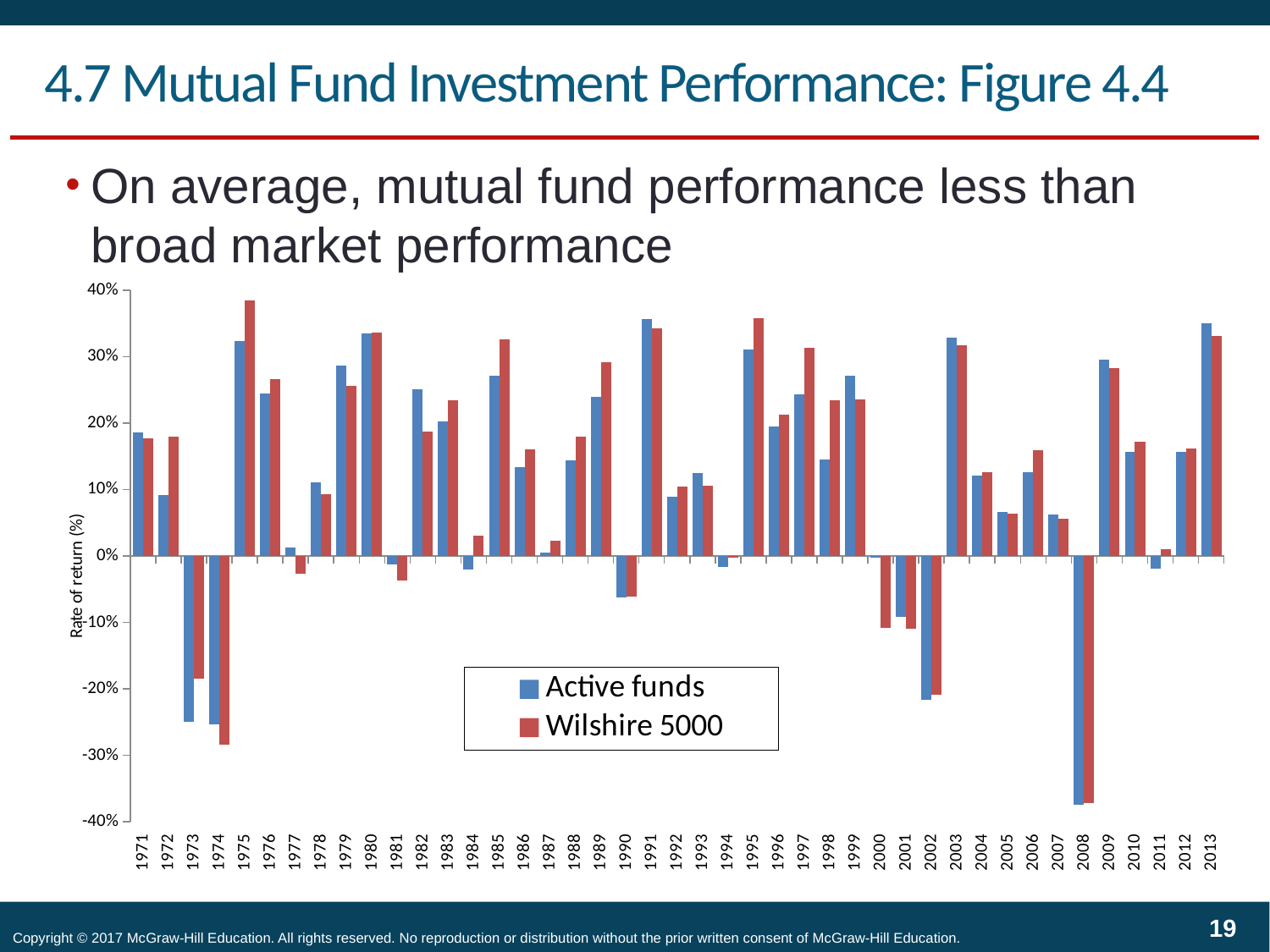
How many years are shown along the x axis of the chart? 43 In 1975, which series has the larger rate of return, Active funds or Wilshire 5000? Wilshire 5000 Is the Active funds value for 1995 greater or less than 20%? greater In 1982, which series has the larger rate of return, Active funds or Wilshire 5000? Active funds In which year is the Active funds rate of return the lowest? 2008 Is the Wilshire 5000 value for 2008 greater or less than -30%? less What is the label on the vertical axis of the chart? Rate of return (%) What kind of chart is shown on the slide? Bar chart What are the two series named in the legend? Active funds and Wilshire 5000 How many series does the chart's legend list? 2 In which year is the Wilshire 5000 rate of return the highest? 1975 Is the Active funds value for 1973 greater or less than -20%? less